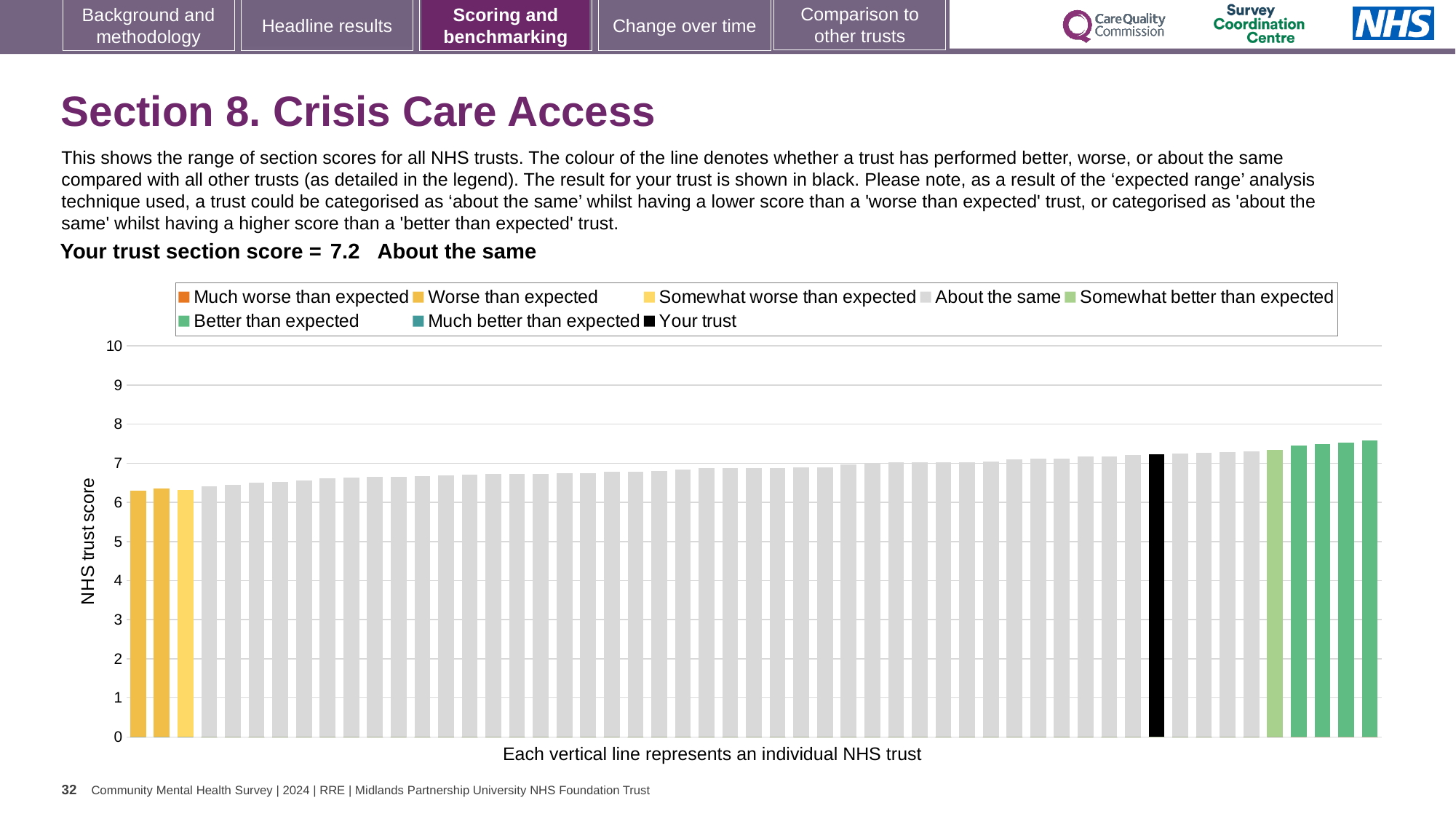
What is the label on the vertical axis of the chart? NHS trust score How many bars are coloured as 'Better than expected'? 4 Is the value of the tallest bar greater or less than 8? less How many entries does the chart legend list? 8 What kind of chart is shown on the slide? Bar chart Which category is your trust placed in for this section? About the same How many bars are coloured as 'Worse than expected'? 2 Which legend category does the tallest bar belong to? Better than expected Is the value for your trust greater or less than 7? greater Is the value of the shortest bar greater or less than 7? less What is the section score for your trust shown on the slide? 7.2 Do the bar values rise or fall from left to right along the x axis? Rise